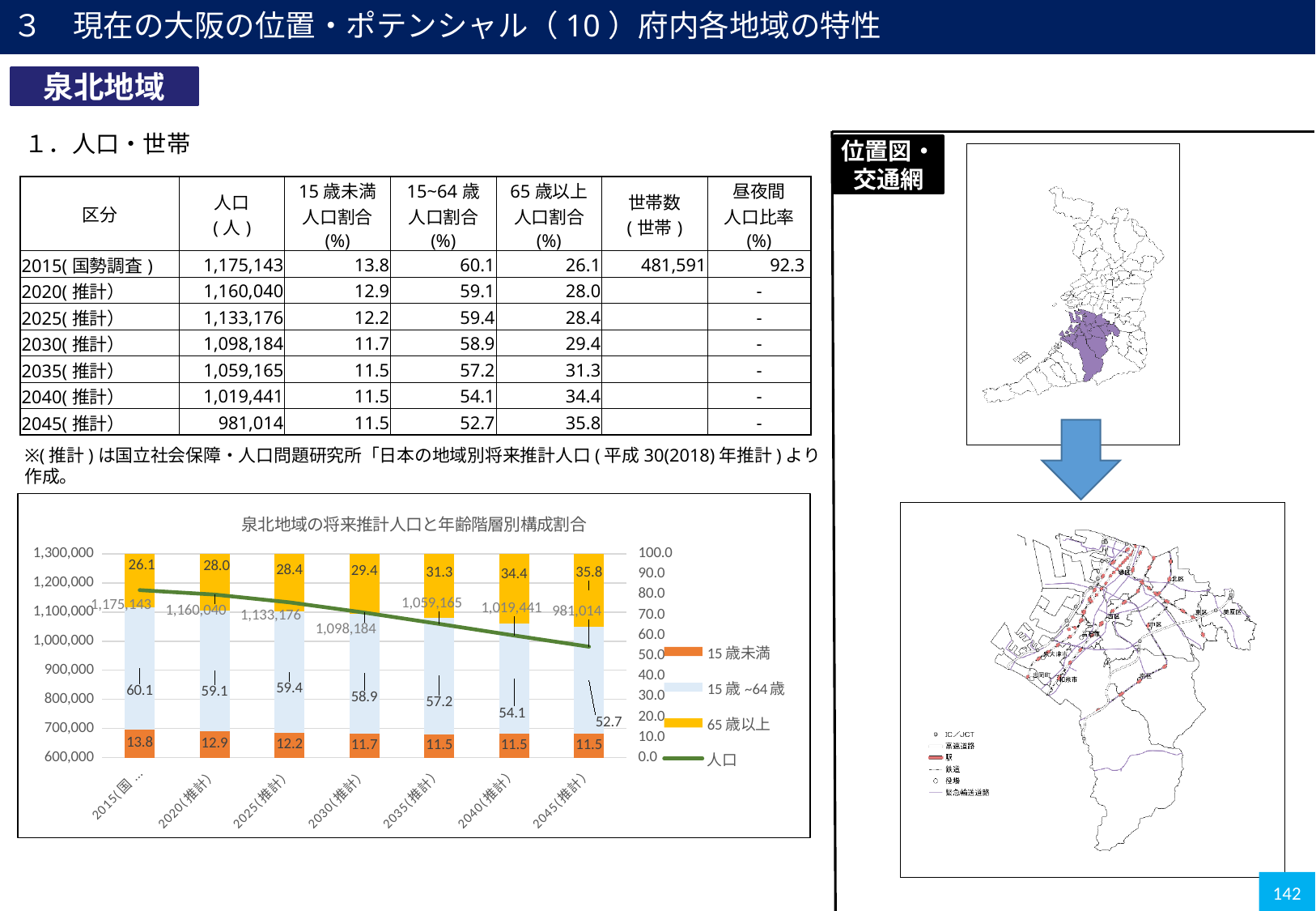
In the chart, what is the difference between the 人口 value for 2015 and the 人口 value for 2045(推計)? 194,129 In the chart, what is the 人口 value shown for 2030(推計)? 1,098,184 In the chart, which year has the lowest 人口 value? 2045(推計) In the chart, does the 人口 line rise or fall from 2015 to 2045(推計)? Fall In the chart, what is the value of the 15歳未満 series for 2015? 13.8 How many year categories are shown on the x axis of the chart? 7 In the chart, by how much does the 65歳以上 value for 2045(推計) exceed the 65歳以上 value for 2015? 9.7 In the chart 泉北地域の将来推計人口と年齢階層別構成割合, what is the value of the 65歳以上 series for 2045(推計)? 35.8 How many series does the chart's legend list? 4 What kind of chart is shown on the slide? A stacked bar chart combined with a line chart In the chart, which is larger: the 15歳~64歳 value for 2020(推計) or for 2025(推計)? 2025(推計) In the chart, which year has the highest value for the 65歳以上 series? 2045(推計)